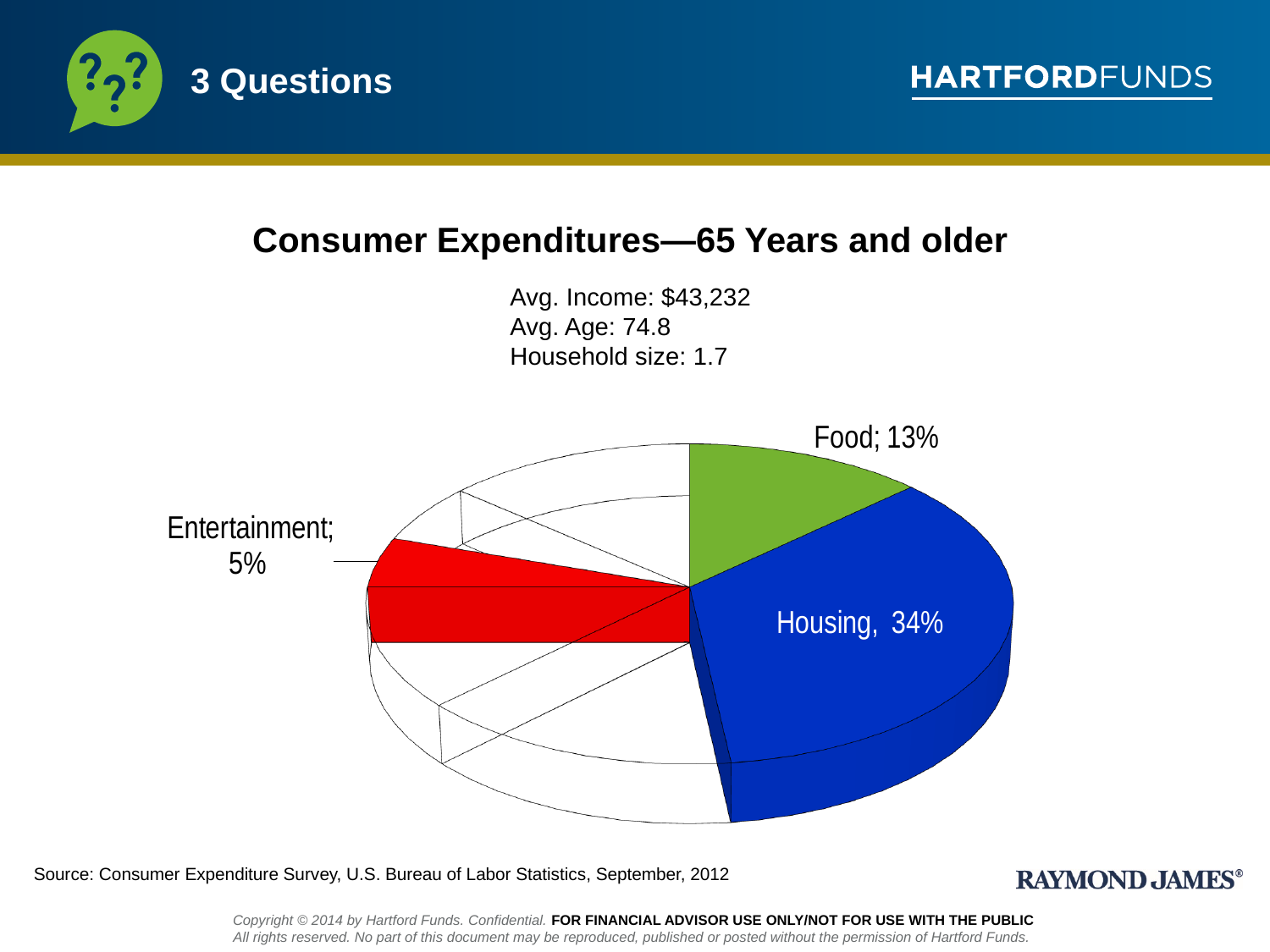
What colour is the Housing slice of the pie? Blue What type of chart is used on this slide? Pie chart What share of expenditures is labeled for Food? 13% How many slices of the pie have a category label and percentage printed? 3 What percentage is shown for Entertainment? 5% Which labeled category has the largest share of expenditures? Housing How many percentage points larger is the Housing share than the Food share? 21 percentage points What is the title of the chart? Consumer Expenditures—65 Years and older Which labeled category has the smallest share of expenditures? Entertainment What percentage of consumer expenditures goes to Housing? 34% What is the difference between the Food share and the Entertainment share? 8 percentage points Which is larger, the Housing share or the Food share? Housing